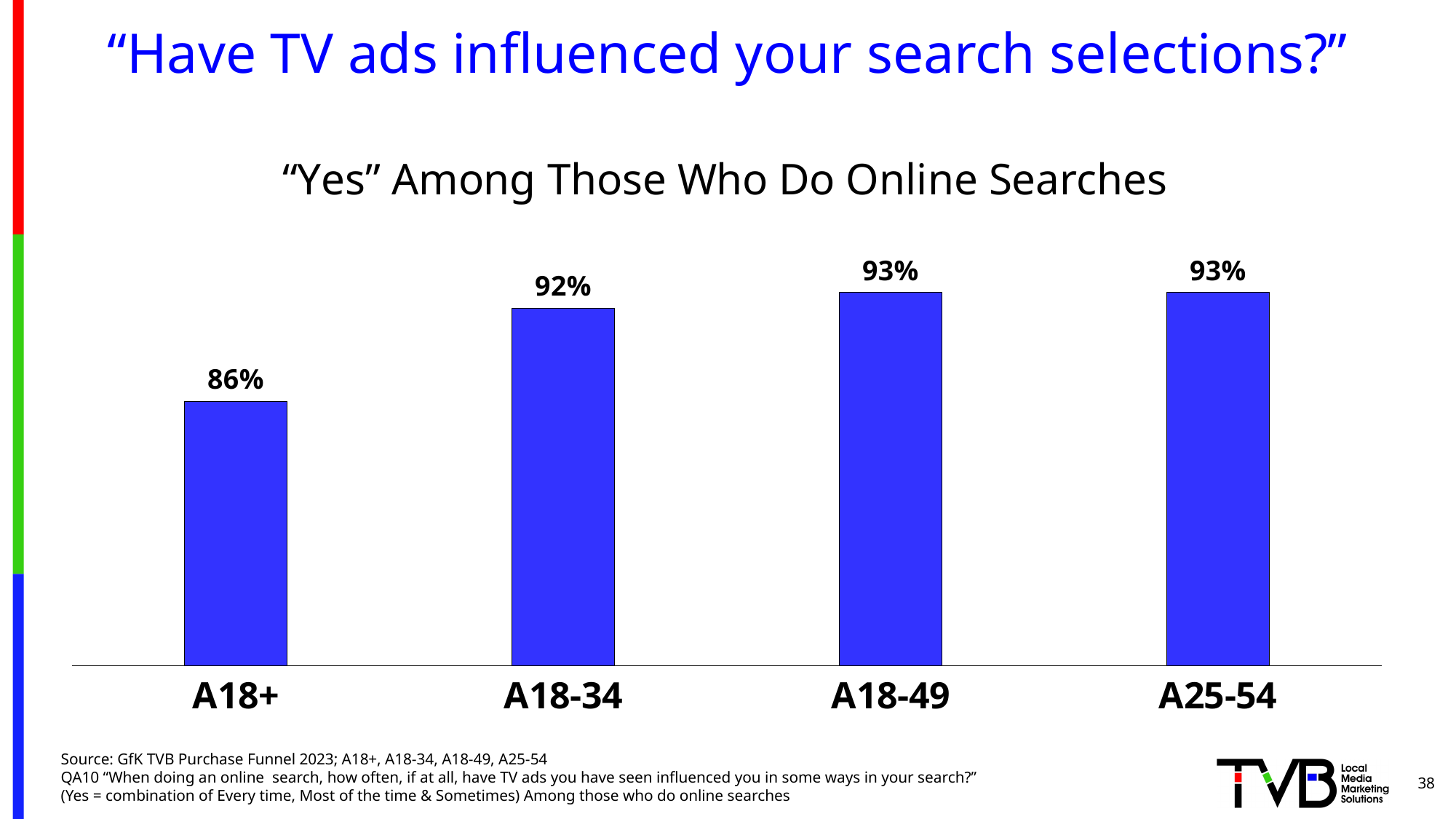
What is the value shown for A18-49? 93% What kind of chart is shown on the slide? Bar chart What is the value shown for A18-34? 92% What is the value shown for A25-54? 93% How many age groups are shown in the chart? 4 What is the subtitle above the chart? "Yes" Among Those Who Do Online Searches What is the difference between the A18-49 value and the A18+ value? 7% Do the values rise or fall from A18+ to A18-49? Rise Which is larger, the value for A18-34 or the value for A18+? A18-34 Which age group has the lowest percentage saying yes? A18+ What is the difference between the A18-34 value and the A18+ value? 6% What percentage of A18+ said TV ads influenced their search selections? 86%